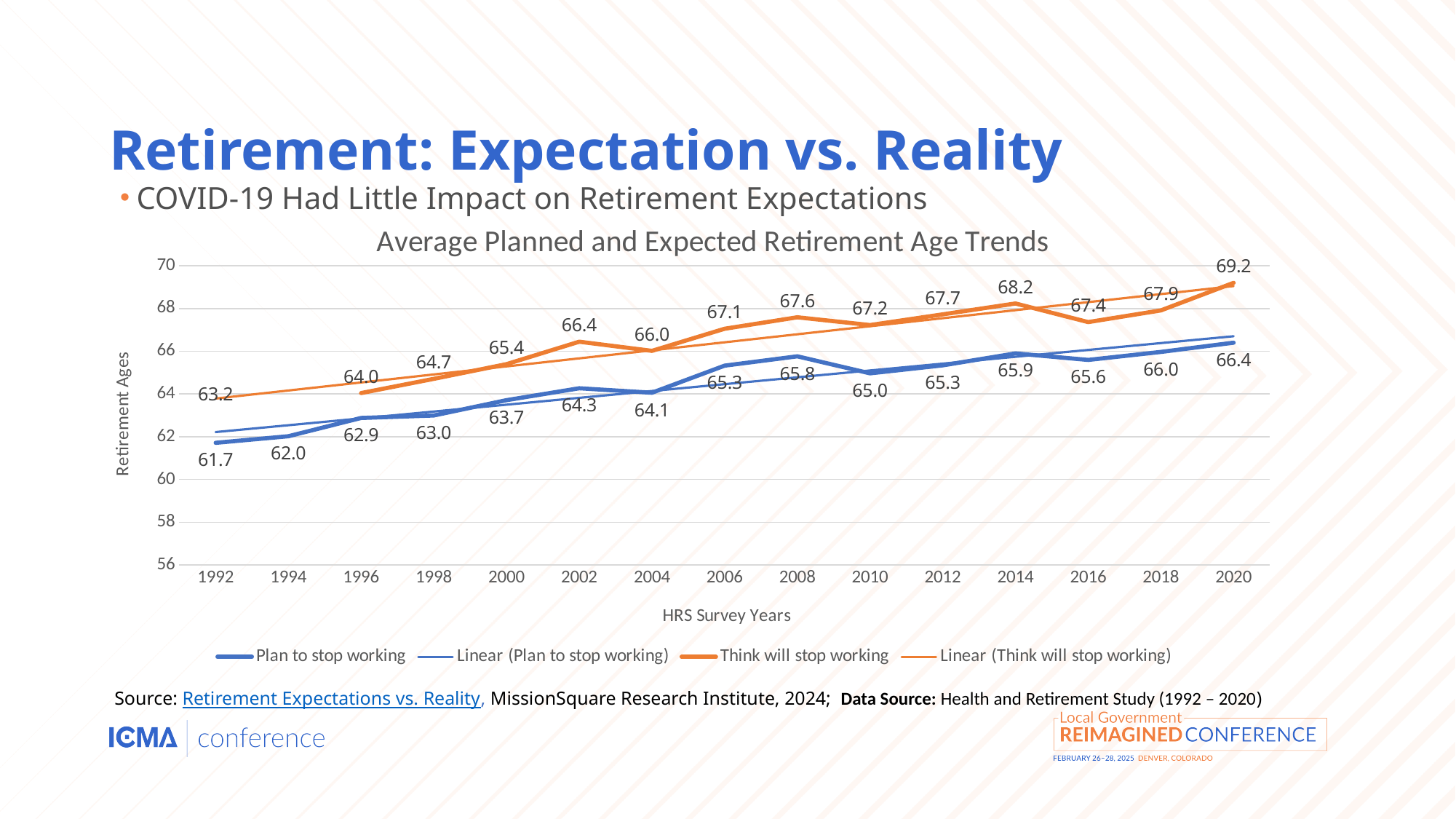
What is the title of the chart? Average Planned and Expected Retirement Age Trends What kind of chart is shown on the slide? Line chart What is the value for Think will stop working in 1992? 63.2 What is the difference between Think will stop working and Plan to stop working in 2020? 2.8 In which year is the Think will stop working series at its highest? 2020 What is the value for Plan to stop working in 2008? 65.8 In which year is the Plan to stop working series at its lowest? 1992 How many entries does the legend list? 4 What is the value for Think will stop working in 2020? 69.2 How many survey years are shown on the x axis? 15 Which is larger for Plan to stop working: the value in 2014 or the value in 2016? 2014 Does the Plan to stop working series generally rise or fall from 1992 to 2020? Rise